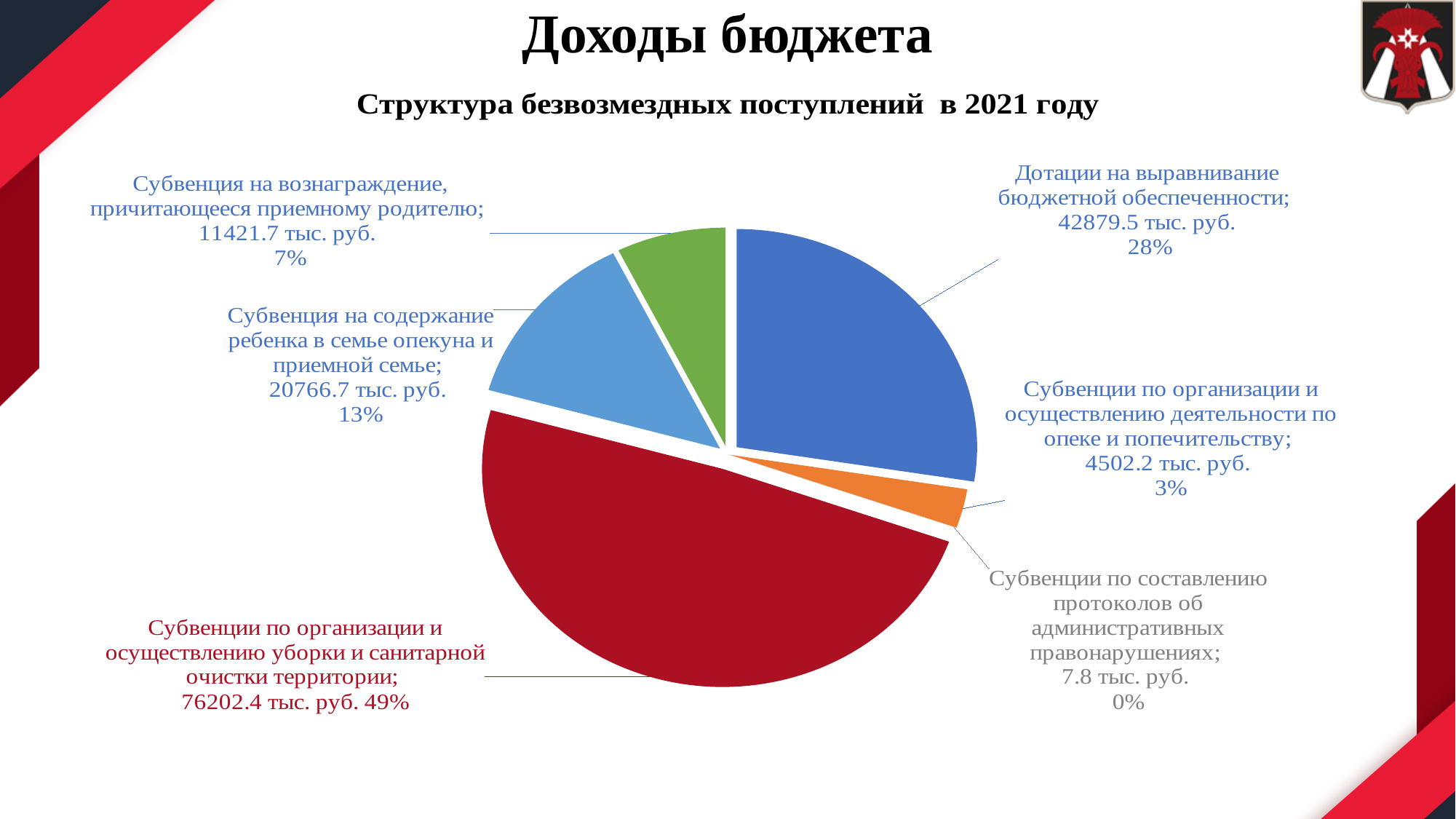
What is the value for "Субвенции по организации и осуществлению уборки и санитарной очистки территории"? 76202.4 тыс. руб. What share of the pie does "Субвенции по организации и осуществлению деятельности по опеке и попечительству" represent? 3% What is the value for "Субвенции по составлению протоколов об административных правонарушениях"? 7.8 тыс. руб. What type of chart is shown on the slide? Pie chart What is the subtitle of the chart on the slide? Структура безвозмездных поступлений в 2021 году Which category has the smallest slice of the pie? Субвенции по составлению протоколов об административных правонарушениях What is the value for "Дотации на выравнивание бюджетной обеспеченности"? 42879.5 тыс. руб. Which is larger: "Субвенция на вознаграждение, причитающееся приемному родителю" or "Субвенции по организации и осуществлению деятельности по опеке и попечительству"? Субвенция на вознаграждение, причитающееся приемному родителю What share of the pie does "Субвенция на содержание ребенка в семье опекуна и приемной семье" represent? 13% How many slices does the pie chart have? 6 Which category has the largest slice of the pie? Субвенции по организации и осуществлению уборки и санитарной очистки территории What is the difference between "Дотации на выравнивание бюджетной обеспеченности" and "Субвенция на содержание ребенка в семье опекуна и приемной семье"? 22112.8 тыс. руб.